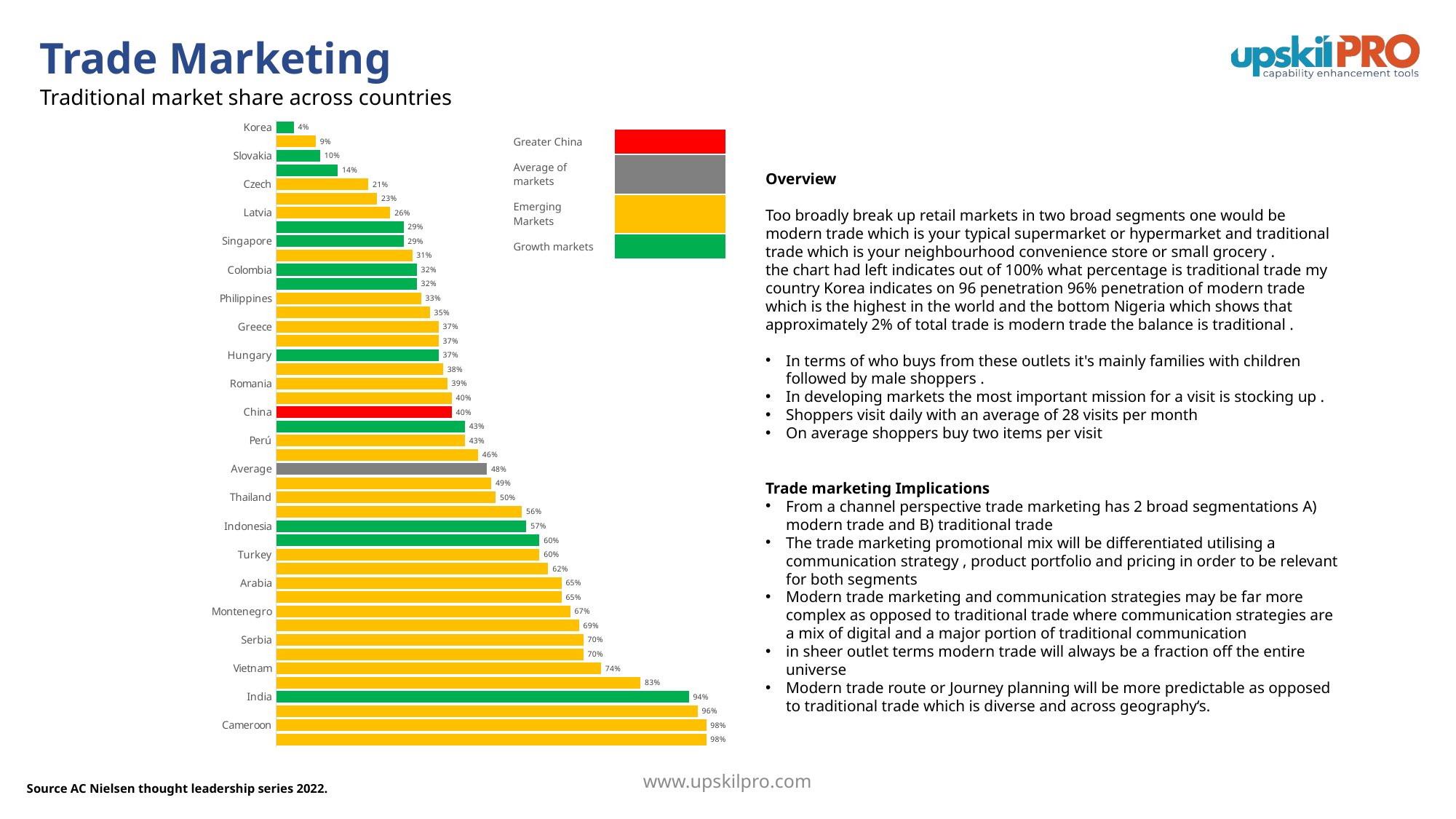
What is the traditional market share value shown for Korea? 4% Which labelled country has the lowest traditional market share? Korea What value is shown for China? 40% What colour is the bar for China? Red Do the bar values increase or decrease going from the top of the chart to the bottom? Increase What value is shown for Vietnam? 74% How many entries does the chart legend list? 4 What value is shown for India? 94% What kind of chart is shown on the slide? Bar chart Which has the larger value, Turkey or Thailand? Turkey What value is shown for the Average bar? 48% What is the difference between the values for India and Korea? 90 percentage points